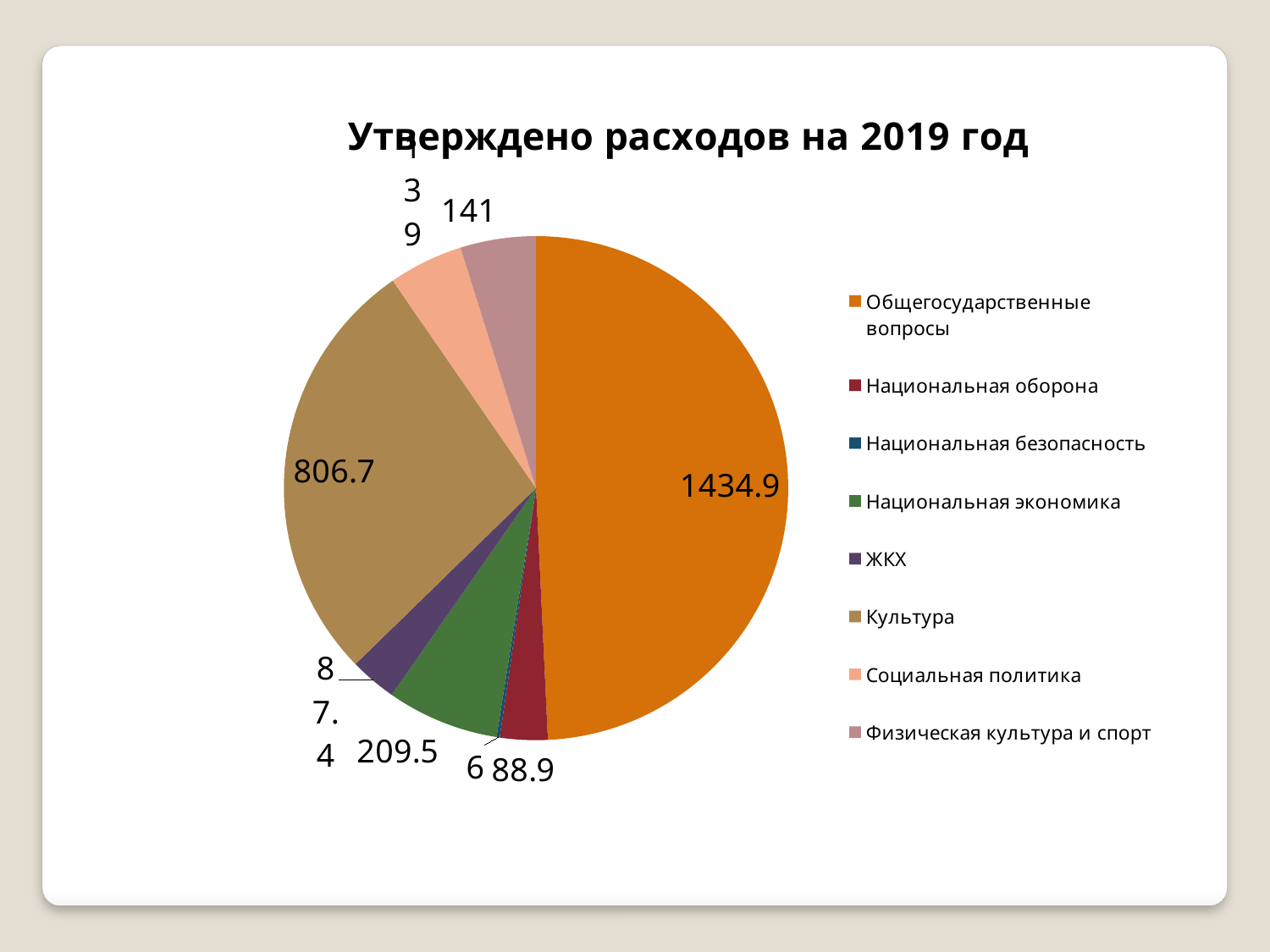
What kind of chart is shown on the slide? pie chart Which is larger, the value for Культура or the value for Национальная экономика? Культура What is the title of the chart? Утверждено расходов на 2019 год How many categories does the legend list? 8 What is the value for Национальная оборона? 88.9 What is the value for Общегосударственные вопросы? 1434.9 What is the value for Культура? 806.7 What is the value for Национальная экономика? 209.5 Which category has the largest slice of the pie? Общегосударственные вопросы Which category has the smallest slice of the pie? Национальная безопасность What is the difference between the values for Общегосударственные вопросы and Культура? 628.2 What is the value for Физическая культура и спорт? 141